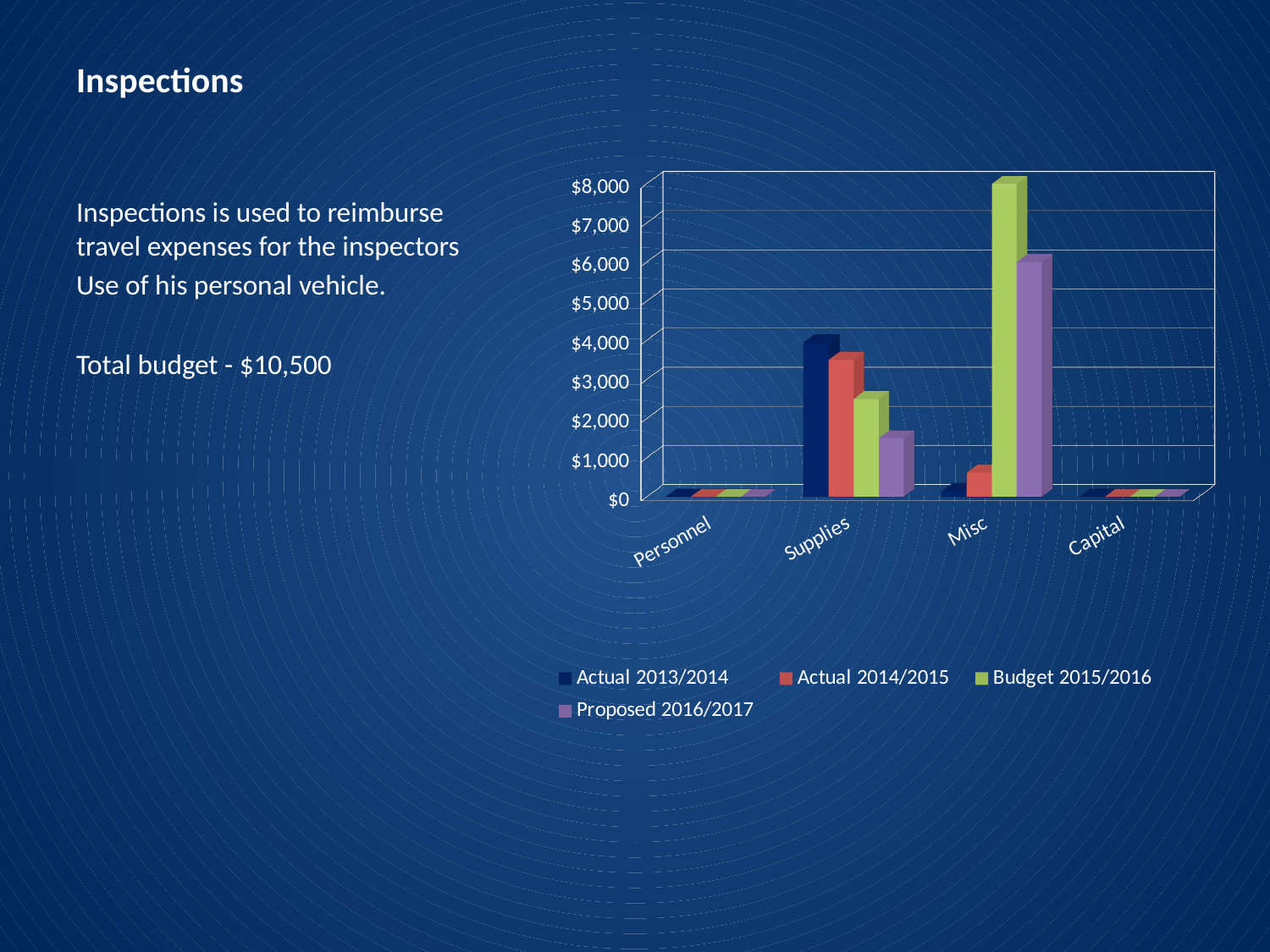
Is the Budget 2015/2016 value for Misc greater or less than $7,000? greater Is the Proposed 2016/2017 value for Supplies greater or less than $2,000? less Which series has the highest value for the Supplies category? Actual 2013/2014 How many series does the chart's legend list? 4 Which series has the highest value for the Misc category? Budget 2015/2016 For the Supplies category, which is larger: the Actual 2013/2014 value or the Proposed 2016/2017 value? Actual 2013/2014 Is the Actual 2014/2015 value for Misc greater or less than $1,000? less How many categories are shown on the x axis of the chart? 4 Which category has the tallest bar for the Budget 2015/2016 series? Misc What is the last entry listed in the chart's legend? Proposed 2016/2017 What kind of chart is shown on the slide? bar chart